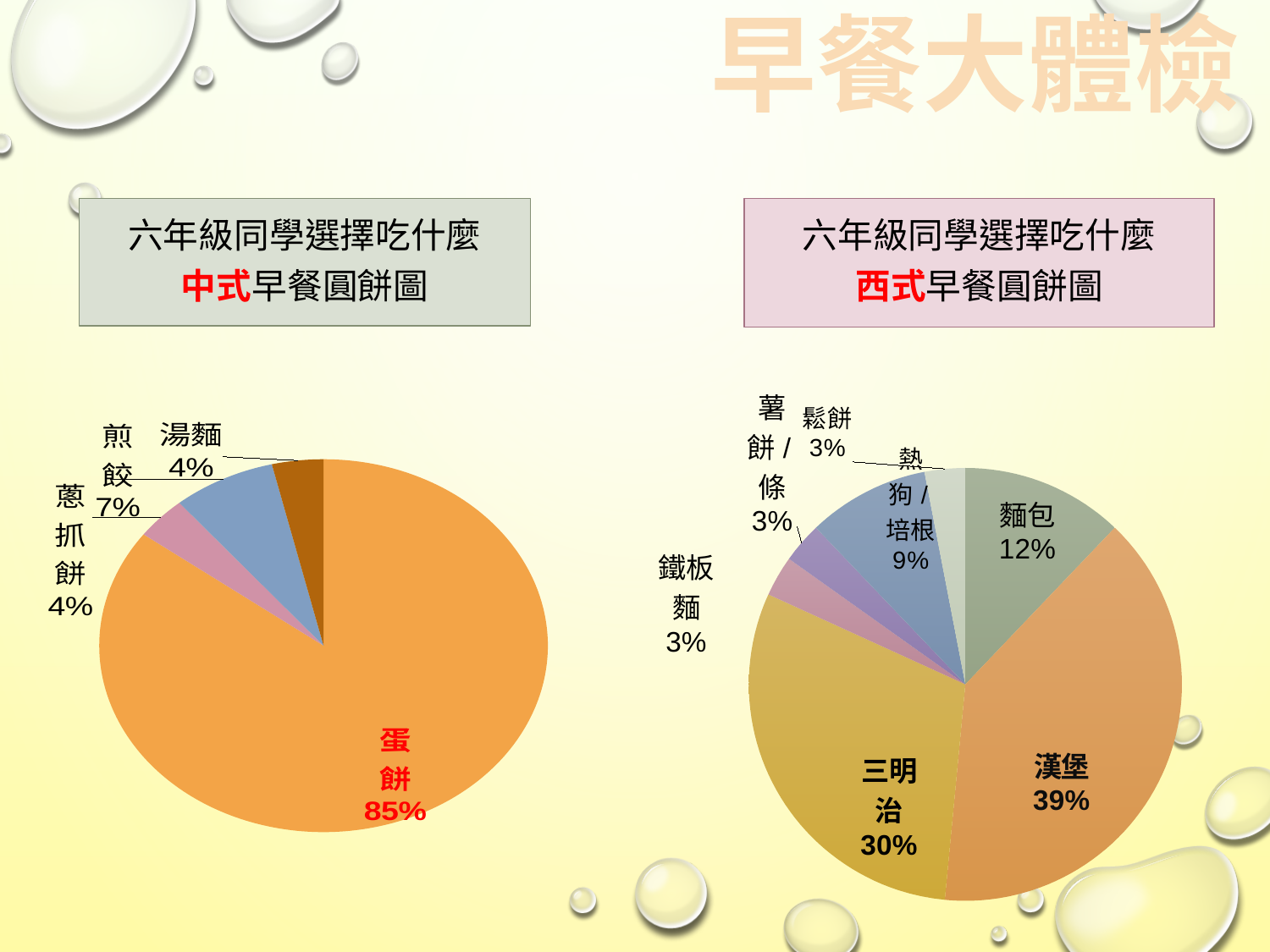
In the right pie chart (西式早餐), what share is labelled for 熱狗/培根? 9% In the right pie chart (西式早餐), which category has the largest slice? 漢堡 In the left pie chart (中式早餐), what share is labelled for 煎餃? 7% In the left pie chart (中式早餐), what share is labelled for 蛋餅? 85% In the right pie chart (西式早餐), which is larger, 三明治 or 麵包? 三明治 In the right pie chart (西式早餐), what share is labelled for 漢堡? 39% What type of chart is used on the left side of the slide? Pie chart In the left pie chart (中式早餐), what is the difference between the shares for 蛋餅 and 煎餃? 78% In the right pie chart (西式早餐), what is the difference between the shares for 漢堡 and 三明治? 9% In the right pie chart (西式早餐), how many categories are shown? 7 In the left pie chart (中式早餐), how many categories are shown? 4 In the left pie chart (中式早餐), which category has the largest slice? 蛋餅